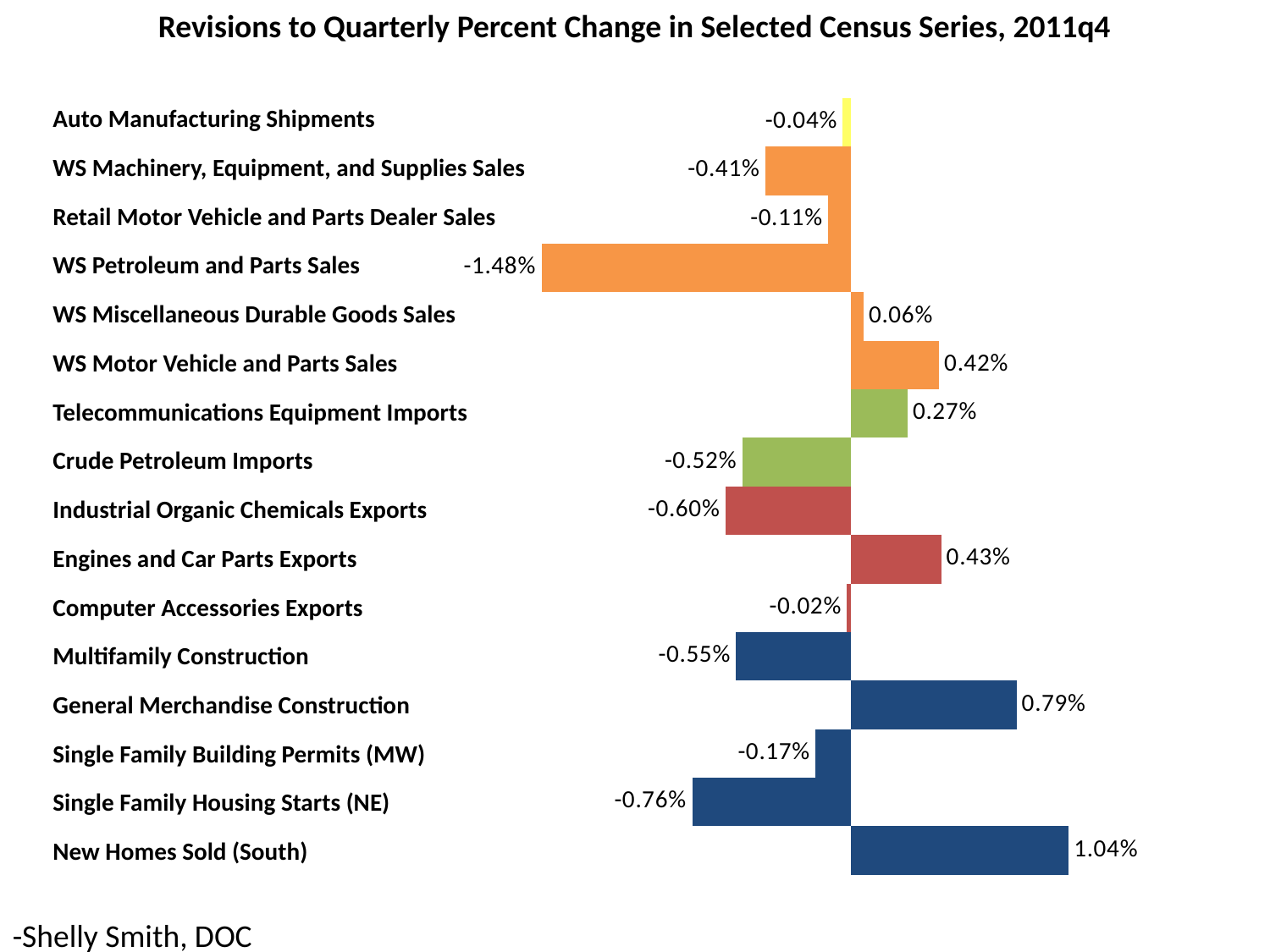
What is the value for WS Petroleum and Parts Sales? -1.48% What is the value for Single Family Housing Starts (NE)? -0.76% What is the value for Telecommunications Equipment Imports? 0.27% How many categories are shown in the chart? 16 What is the title of the chart? Revisions to Quarterly Percent Change in Selected Census Series, 2011q4 Which category has the highest value? New Homes Sold (South) Which is larger, the value for General Merchandise Construction or the value for Engines and Car Parts Exports? General Merchandise Construction What is the difference between the values for New Homes Sold (South) and General Merchandise Construction? 0.25 percentage points Which is larger, the value for Crude Petroleum Imports or the value for Industrial Organic Chemicals Exports? Crude Petroleum Imports Which category has the lowest value? WS Petroleum and Parts Sales What kind of chart is shown on the slide? Bar chart What is the value for New Homes Sold (South)? 1.04%